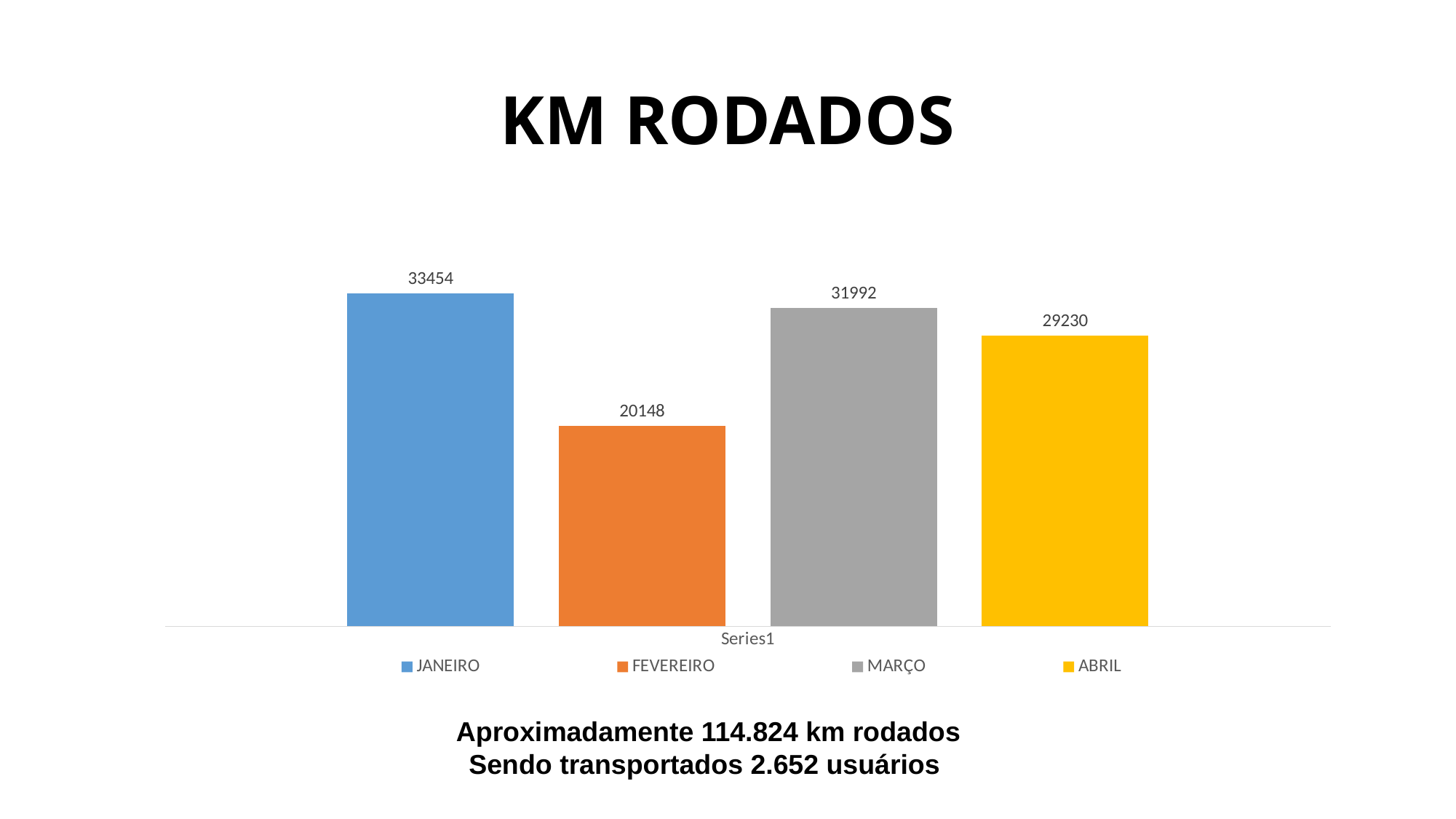
How many bars are shown in the chart? 4 What is the difference between the values for MARÇO and ABRIL? 2762 What is the title of the chart? KM RODADOS What is the value for ABRIL? 29230 Which is larger, the value for MARÇO or the value for ABRIL? MARÇO What is the value for FEVEREIRO? 20148 What is the difference between the values for JANEIRO and FEVEREIRO? 13306 What kind of chart is shown on the slide? Bar chart Which month has the lowest value? FEVEREIRO What is the value for MARÇO? 31992 Which month has the highest value? JANEIRO What is the value for JANEIRO? 33454